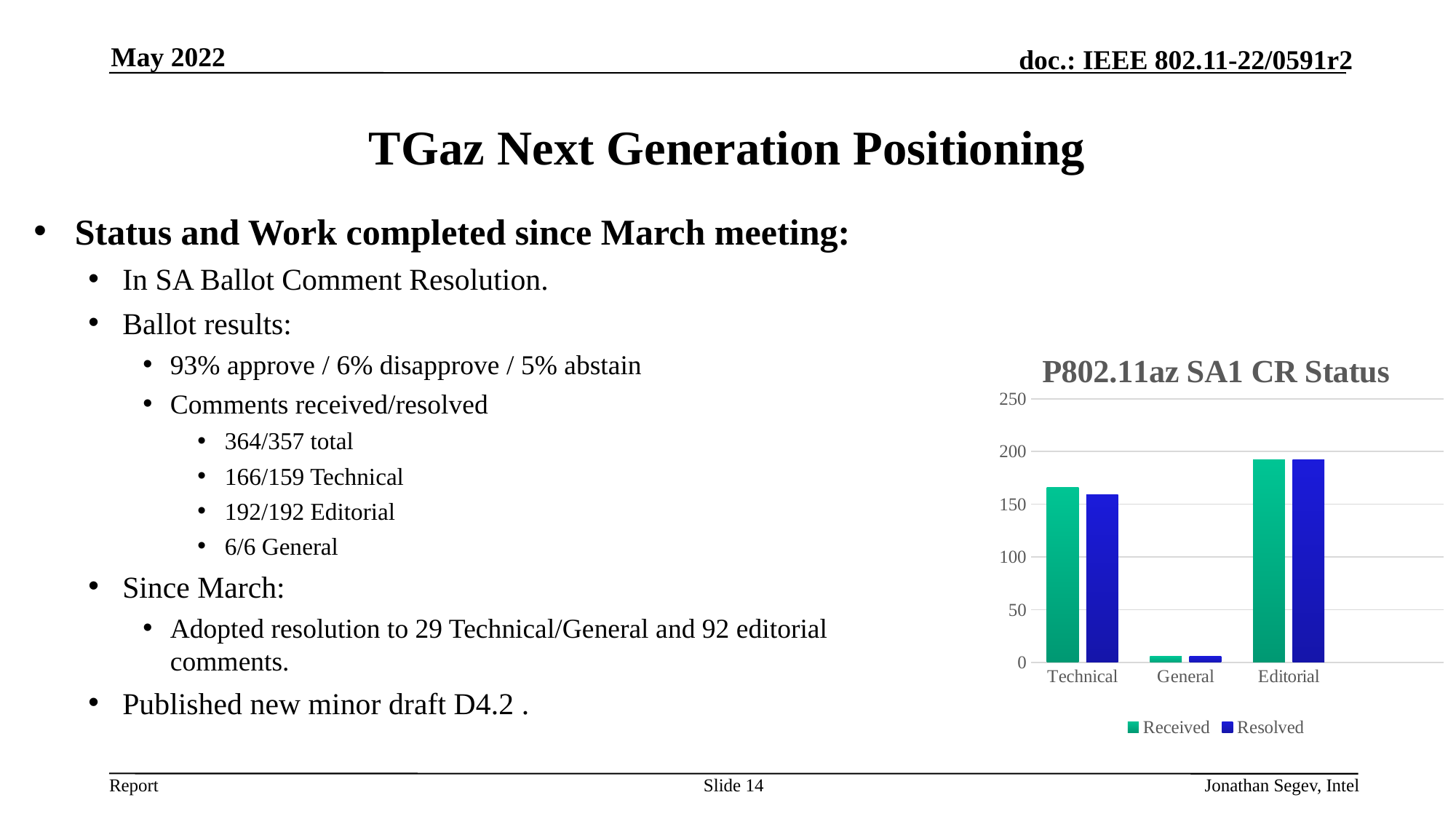
Which category has the highest Received value? Editorial Is the Resolved value for Editorial greater or less than 200? less What is the title of the chart? P802.11az SA1 CR Status What type of chart is shown on the slide? bar chart Which series is shown in green in the chart? Received How many series does the chart legend list? 2 Is the Received value for Technical greater or less than 150? greater Is the Resolved value for Technical greater or less than 100? greater Which category has the lowest Resolved value? General For Technical, which is larger: Received or Resolved? Received How many categories are shown on the x axis of the chart? 3